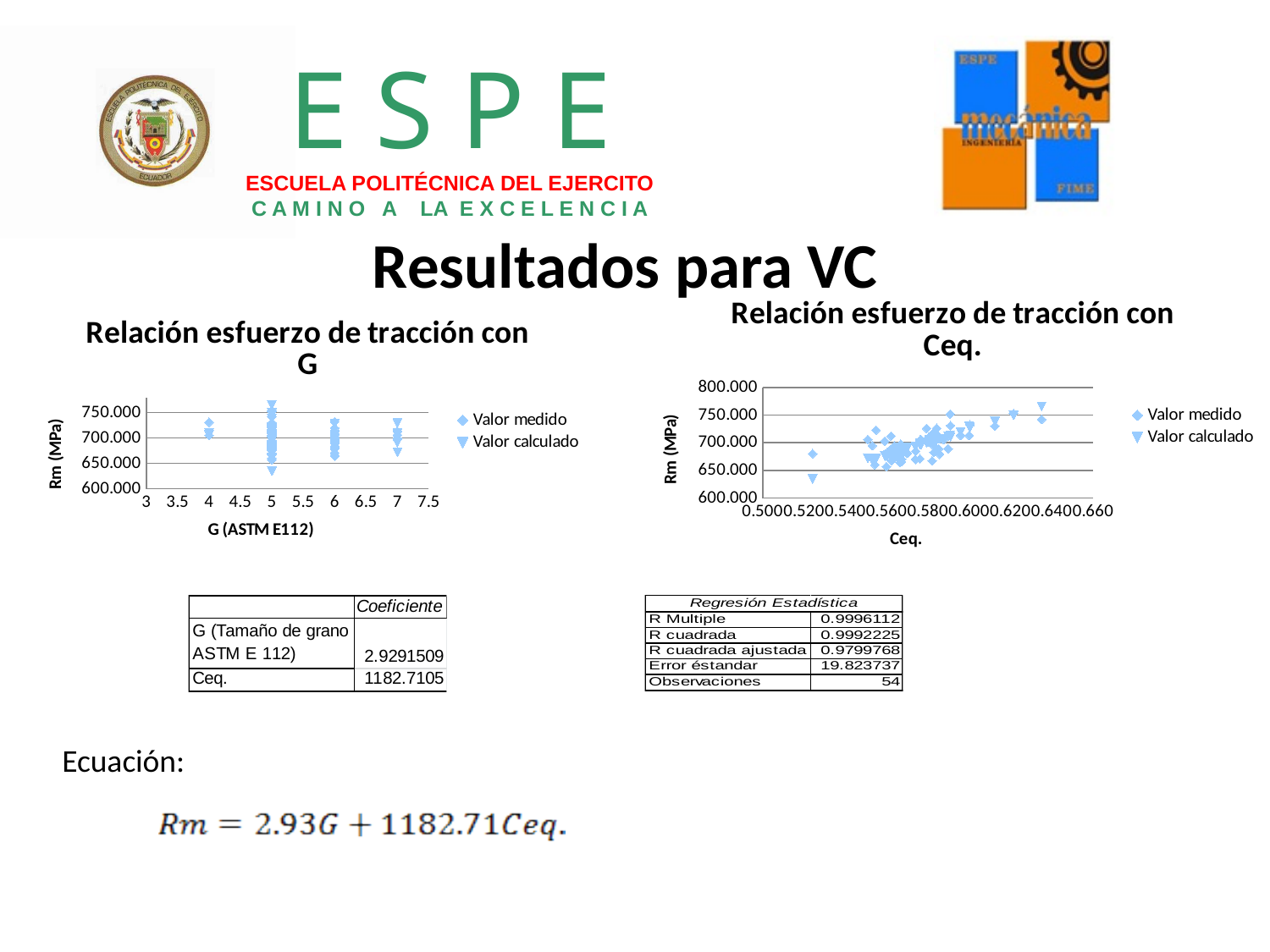
In the chart titled "Relación esfuerzo de tracción con Ceq.", is the highest Valor calculado point (near Ceq. 0.635) greater or less than 750.000? greater What kind of chart is the chart titled "Relación esfuerzo de tracción con Ceq."? scatter chart What is the y-axis title of the chart titled "Relación esfuerzo de tracción con Ceq."? Rm (MPa) How many series does the legend of the chart titled "Relación esfuerzo de tracción con G" list? 2 What kind of chart is the chart titled "Relación esfuerzo de tracción con G"? scatter chart In the chart titled "Relación esfuerzo de tracción con G", are the Valor medido points at G = 4 greater or less than 650.000? greater How many series does the legend of the chart titled "Relación esfuerzo de tracción con Ceq." list? 2 What is the x-axis title of the chart titled "Relación esfuerzo de tracción con G"? G (ASTM E112) In the chart titled "Relación esfuerzo de tracción con G", are the points at G = 7 greater or less than 750.000? less In the chart titled "Relación esfuerzo de tracción con G", at how many distinct G values are points plotted? 4 In the chart titled "Relación esfuerzo de tracción con Ceq.", do the Rm values generally rise or fall as Ceq. increases? rise